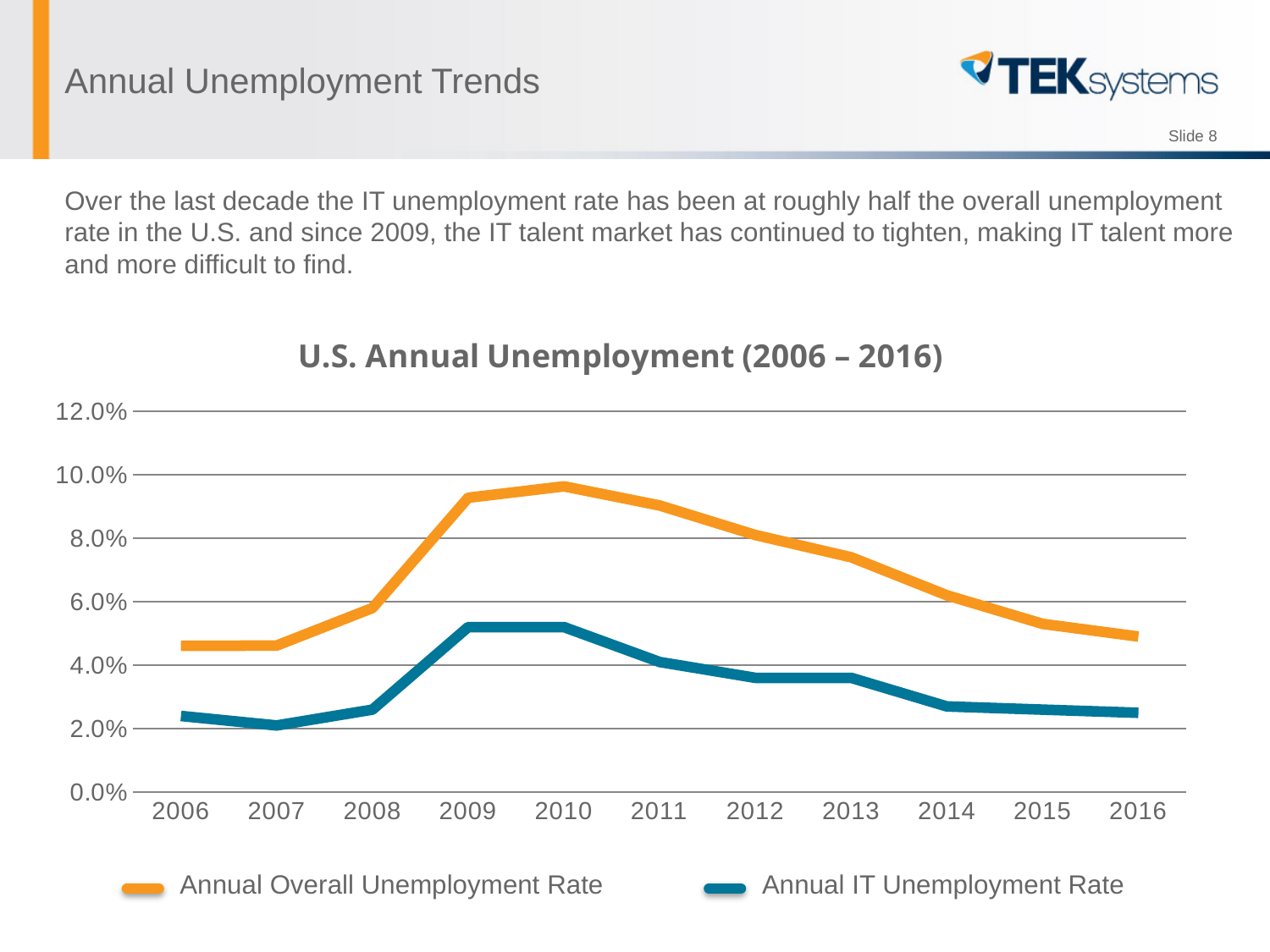
Which year has the lowest Annual IT Unemployment Rate? 2007 Is the Annual IT Unemployment Rate for 2007 greater or less than 4.0%? less Which year has the highest Annual Overall Unemployment Rate? 2010 How many years are shown on the x axis? 11 Which is larger: the Annual Overall Unemployment Rate in 2009 or in 2006? 2009 Is the Annual IT Unemployment Rate for 2009 greater or less than 4.0%? greater What is the title of the chart? U.S. Annual Unemployment (2006 – 2016) How many series does the legend list? 2 Is the Annual Overall Unemployment Rate for 2010 greater or less than 8.0%? greater Does the Annual Overall Unemployment Rate rise or fall from 2010 to 2016? fall What kind of chart is shown on the slide? line chart